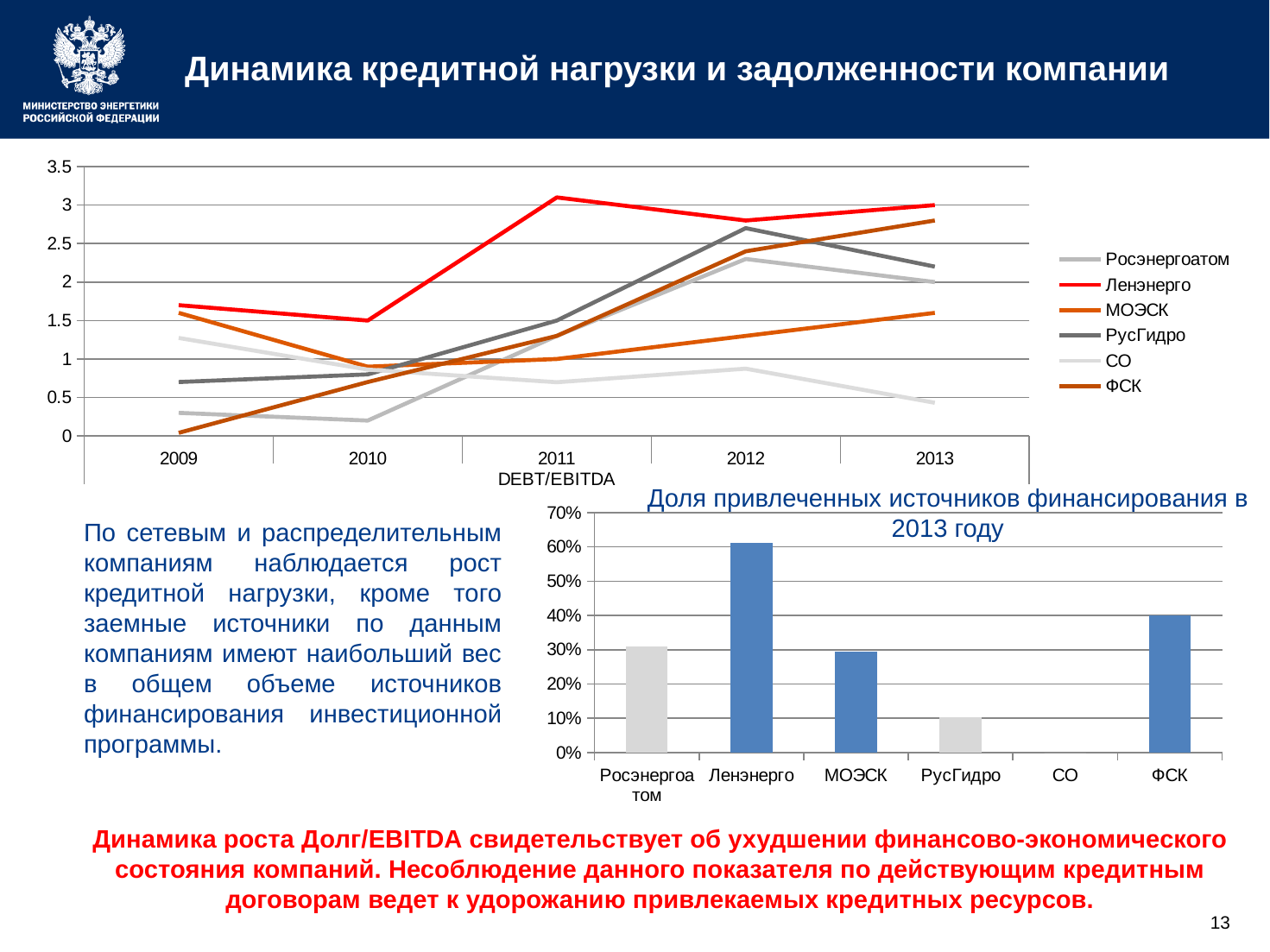
In the DEBT/EBITDA line chart, which company has the lowest value in 2009? ФСК In the DEBT/EBITDA line chart, is the value for Росэнергоатом in 2010 greater or less than 0.5? less What type of chart is the DEBT/EBITDA chart at the top of the slide? line chart In the DEBT/EBITDA line chart, is the value for Ленэнерго in 2011 greater or less than 2.5? greater How many companies are shown on the x axis of the chart 'Доля привлеченных источников финансирования в 2013 году'? 6 What type of chart is 'Доля привлеченных источников финансирования в 2013 году'? bar chart In the chart 'Доля привлеченных источников финансирования в 2013 году', is the value for Ленэнерго greater or less than 50%? greater In the DEBT/EBITDA line chart, does the value for ФСК rise or fall from 2009 to 2013? rise In the DEBT/EBITDA line chart, which company has the highest value in 2011? Ленэнерго In the DEBT/EBITDA line chart, which company has the lowest value in 2013? СО In the chart 'Доля привлеченных источников финансирования в 2013 году', which company has the highest share? Ленэнерго How many series does the legend of the DEBT/EBITDA line chart list? 6